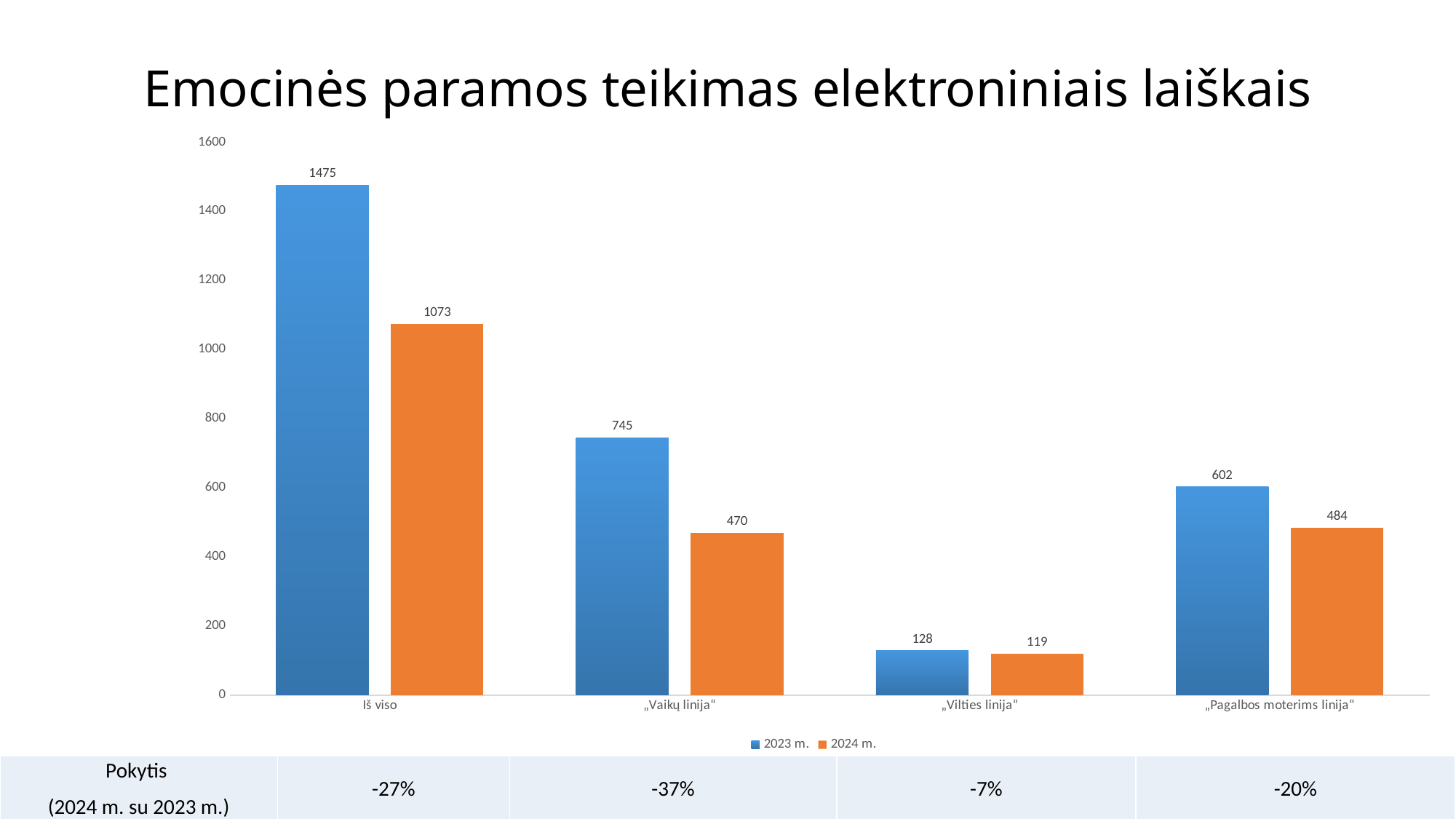
Which is larger for „Vilties linija“: the 2023 m. value or the 2024 m. value? 2023 m. What is the value for „Pagalbos moterims linija“ in the 2024 m. series? 484 Which category has the highest value in the 2023 m. series? Iš viso How many series does the legend list? 2 How many categories are shown on the x axis? 4 What is the difference between the 2023 m. and 2024 m. values for „Vaikų linija“? 275 What is the title of the slide? Emocinės paramos teikimas elektroniniais laiškais What is the value for „Vaikų linija“ in the 2023 m. series? 745 Which category has the lowest value in the 2024 m. series? „Vilties linija“ What kind of chart is shown on the slide? Bar chart What is the difference between the 2023 m. and 2024 m. values for Iš viso? 402 What is the value for Iš viso in the 2024 m. series? 1073